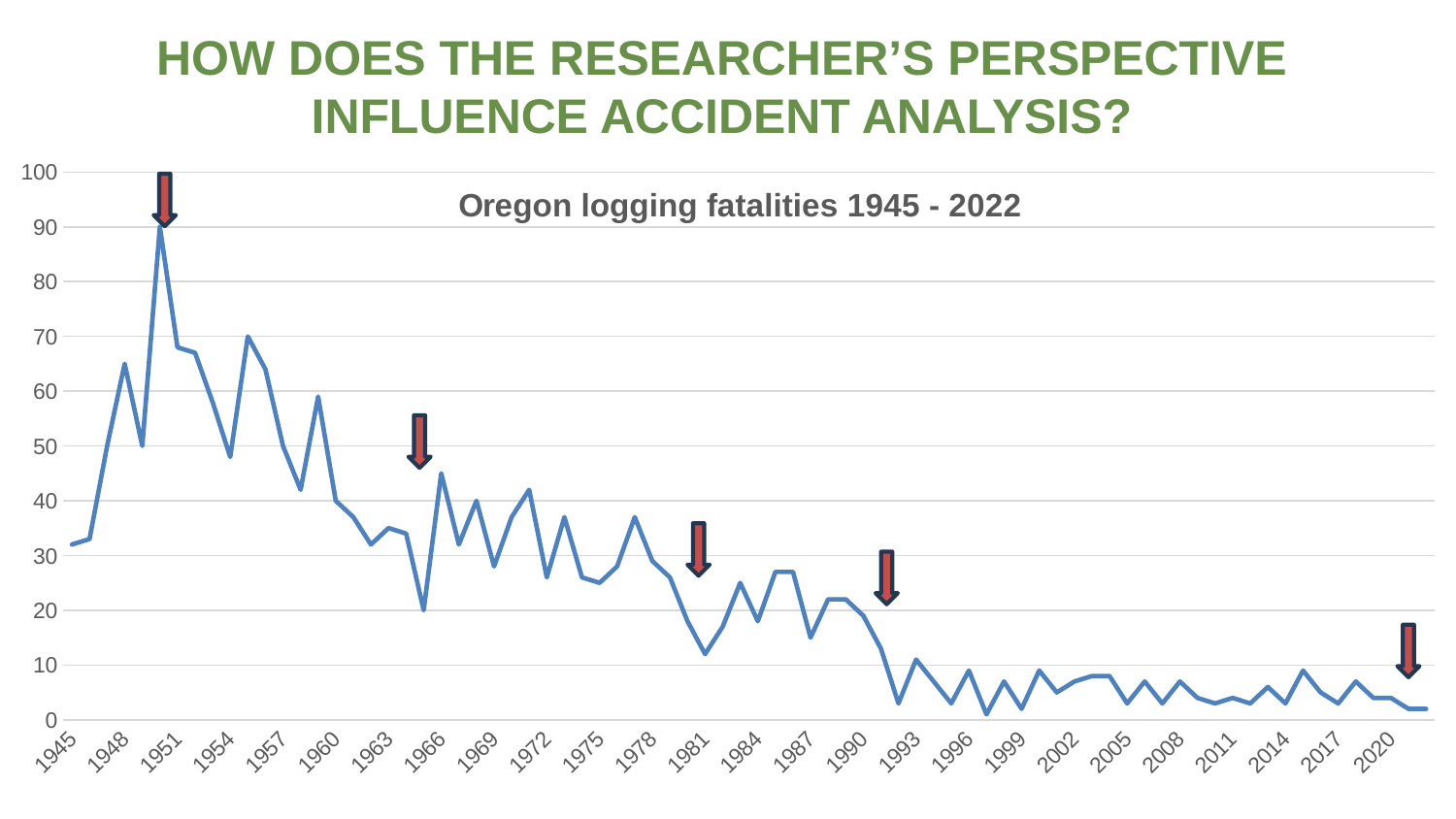
Is the value for 1951 greater or less than 60? greater Which year has the larger value, 1945 or 2020? 1945 How many red arrows are drawn on the chart? 5 Is the value for 1999 greater or less than 10? less Which year has the larger value, 1951 or 1981? 1951 What is the title of the chart? Oregon logging fatalities 1945 - 2022 Is the value for 1981 greater or less than 20? less In which decade does the highest value on the chart occur? 1950s What kind of chart is shown on the slide? line chart Overall, do the values rise or fall from 1945 to 2022? fall